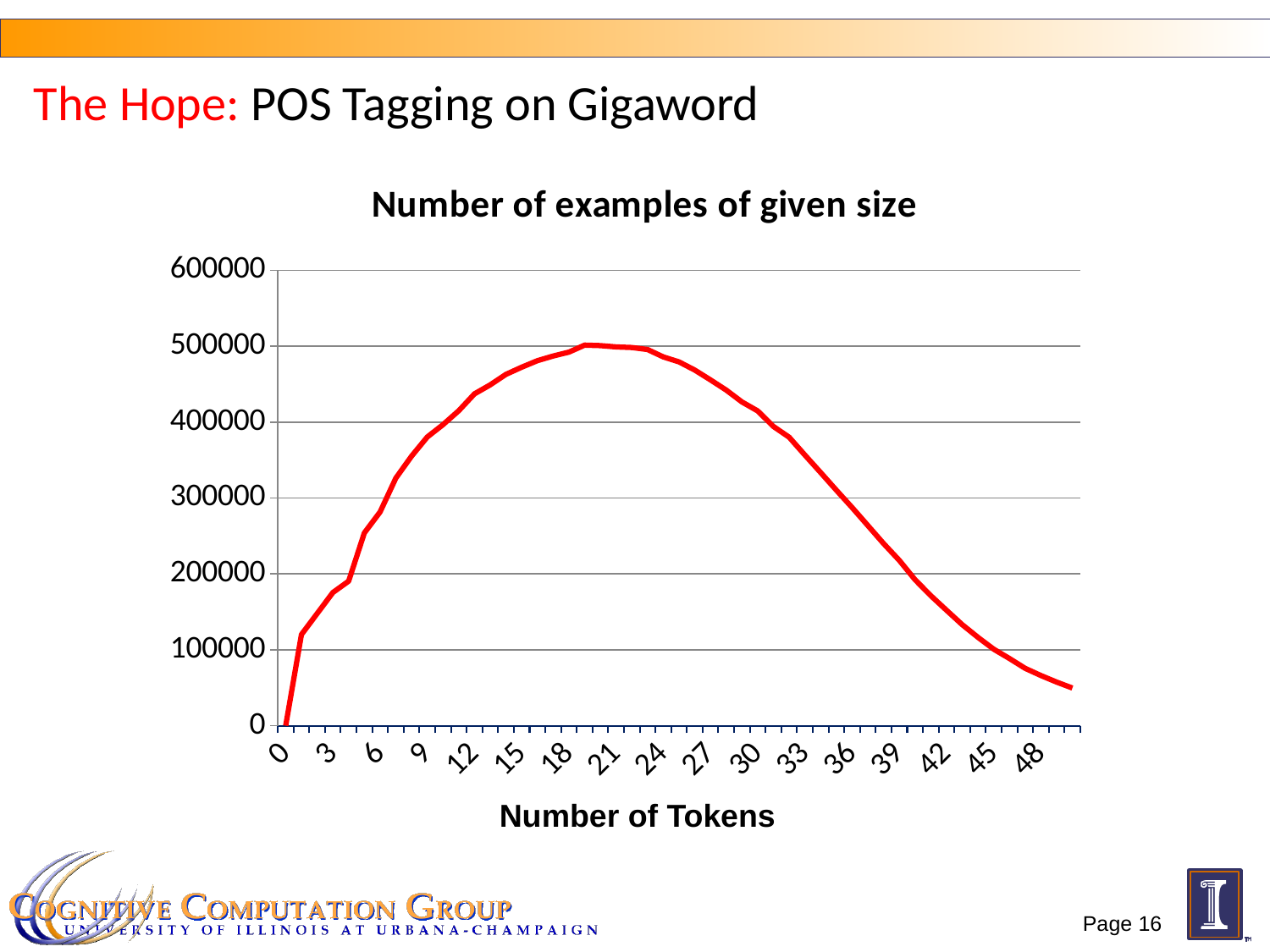
Do the values rise or fall as the number of tokens increases from 24 to 48? fall Is the value at 0 tokens greater or less than 100000? less Is the value at 48 tokens greater or less than 100000? less Is the value at 9 tokens greater or less than 300000? greater What is the label of the x axis? Number of Tokens What is the title of the chart? Number of examples of given size What kind of chart is shown on the slide? line chart